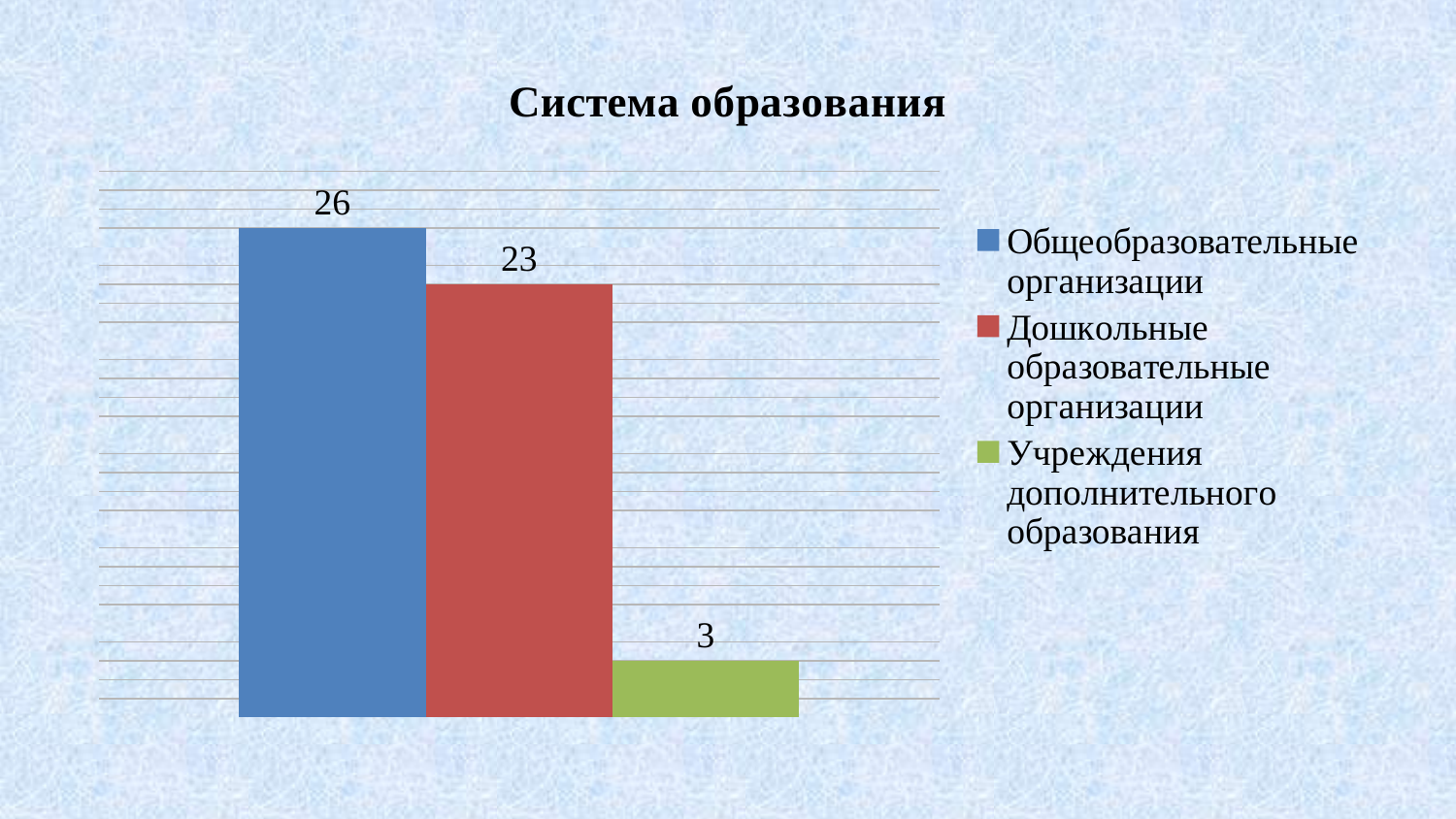
What is the difference between the values for Дошкольные образовательные организации and Учреждения дополнительного образования? 20 What is the value for Дошкольные образовательные организации? 23 What is the title of the chart? Система образования What is the difference between the values for Общеобразовательные организации and Дошкольные образовательные организации? 3 Which category has the highest value? Общеобразовательные организации How many series does the legend list? 3 Which is larger: the value for Дошкольные образовательные организации or the value for Учреждения дополнительного образования? Дошкольные образовательные организации What is the value for Общеобразовательные организации? 26 What is the value for Учреждения дополнительного образования? 3 How many bars are plotted on the chart? 3 Which category has the lowest value? Учреждения дополнительного образования What kind of chart is shown on the slide? Bar chart